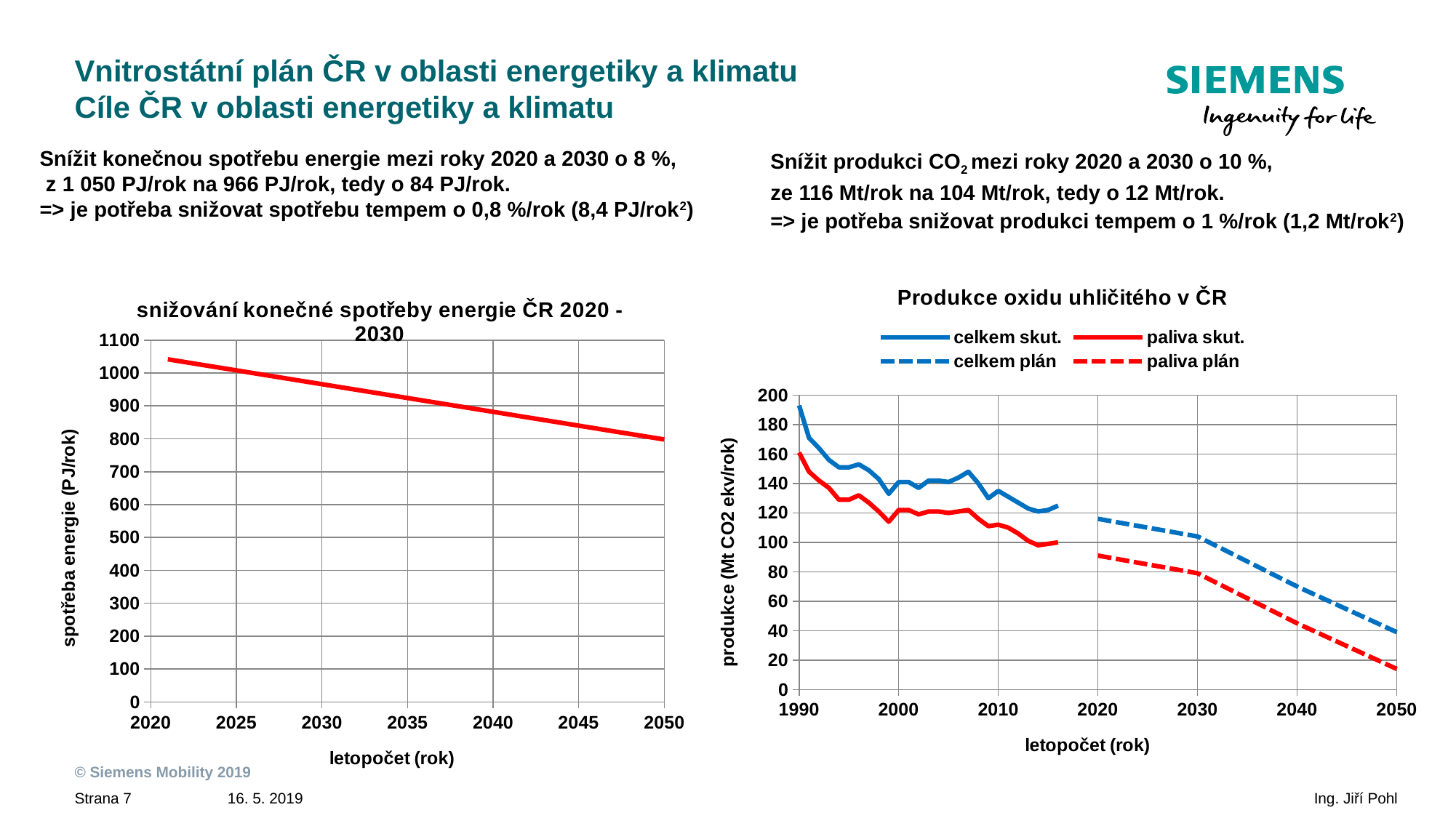
What kind of chart is the left chart titled "snižování konečné spotřeby energie ČR 2020 - 2030"? line chart In the right chart "Produkce oxidu uhličitého v ČR", is the value of "paliva plán" in 2020 greater or less than 100? less In the left chart (snižování konečné spotřeby energie), does the plotted value rise or fall from 2020 to 2050? fall In the right chart "Produkce oxidu uhličitého v ČR", what colour are the "celkem skut." and "celkem plán" lines? blue In the left chart (snižování konečné spotřeby energie), is the value for 2030 greater or less than 900? greater In the right chart "Produkce oxidu uhličitého v ČR", which series is higher in 2000, "celkem skut." or "paliva skut."? celkem skut. What is the y-axis label of the left chart (snižování konečné spotřeby energie)? spotřeba energie (PJ/rok) In the right chart "Produkce oxidu uhličitého v ČR", is the value of "celkem plán" in 2020 greater or less than 100? greater How many series does the legend of the right chart "Produkce oxidu uhličitého v ČR" list? 4 In the right chart "Produkce oxidu uhličitého v ČR", does the "paliva plán" series rise or fall between 2020 and 2050? fall